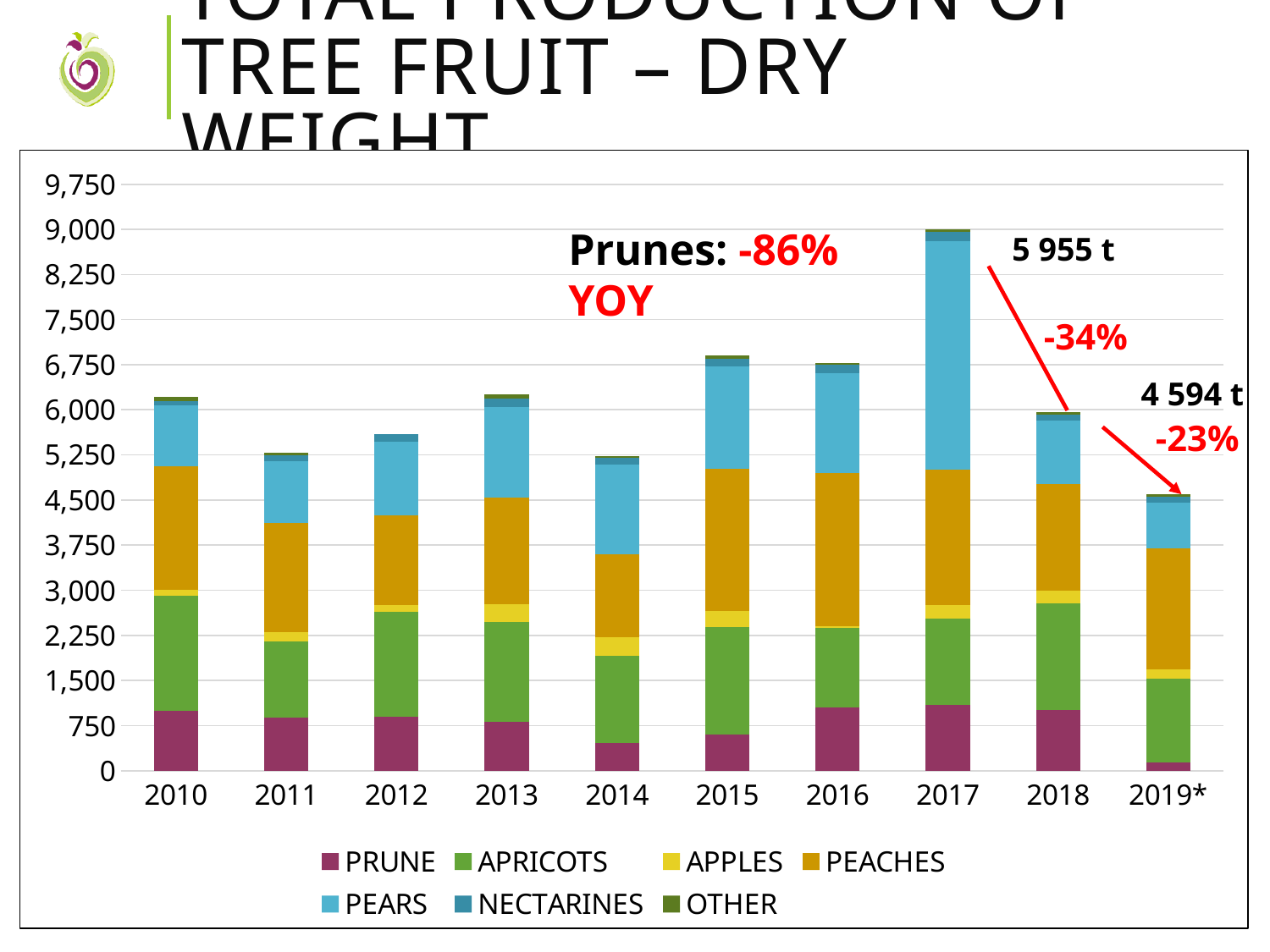
Which year has the larger total production, 2013 or 2014? 2013 What kind of chart is shown on the slide? Stacked bar chart What is the total production labelled for 2018? 5 955 t What year-over-year change is annotated for prunes? -86% How many years are shown on the x axis? 10 Is the total for 2014 greater or less than 6,000? less Which year has the highest total production? 2017 How many series does the legend list? 7 Which year has the lowest total production? 2019* Is the total for 2017 greater or less than 8,250? greater What is the total production labelled for 2019*? 4 594 t What is the difference between the labelled totals for 2018 and 2019*? 1 361 t